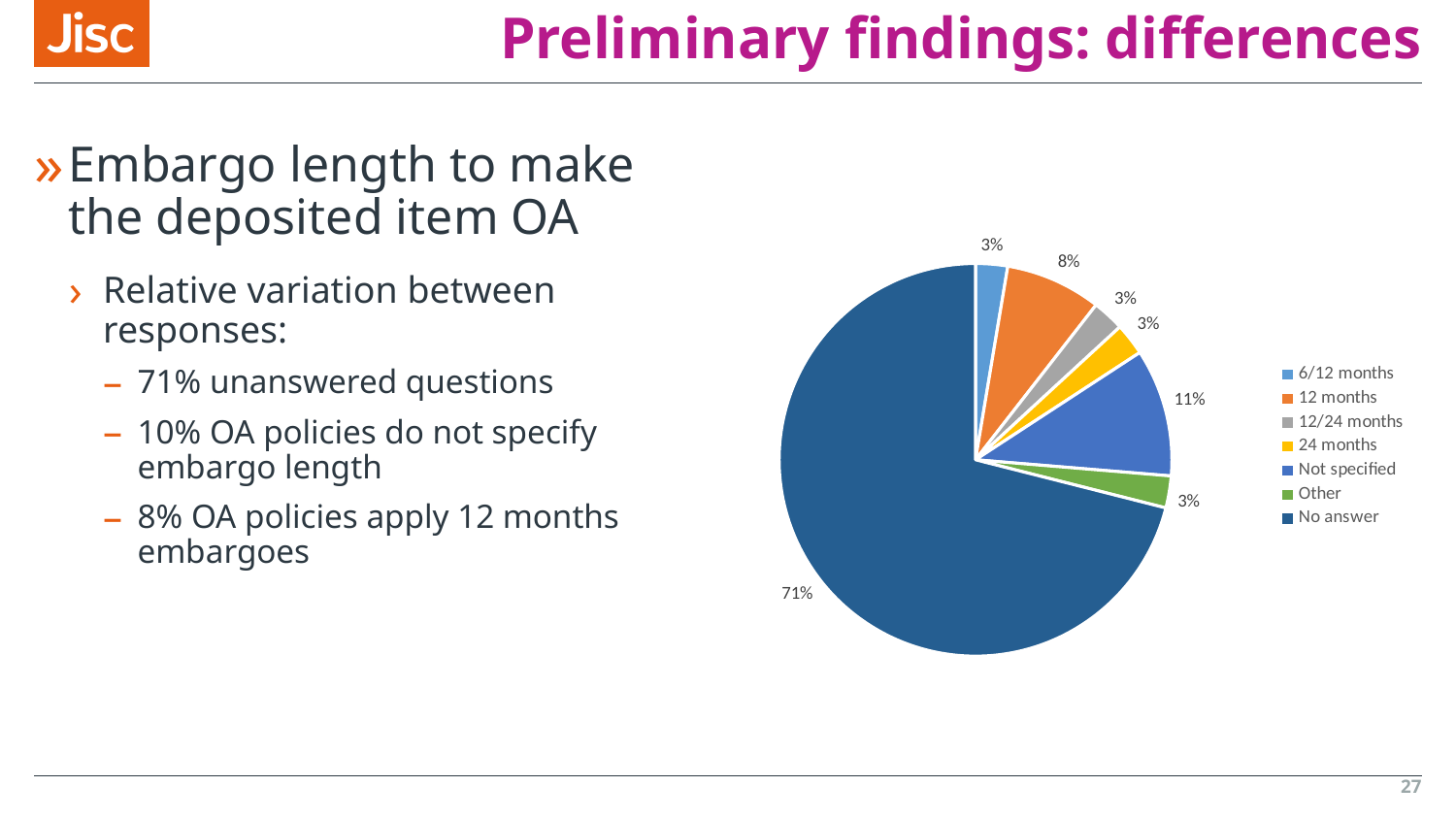
What is the difference between the "No answer" share and the "Not specified" share? 60% Which category has the largest slice of the pie? No answer Which legend entry is shown in yellow? 24 months What is the value shown for "12 months"? 8% How many categories does the legend list? 7 Which legend entry is shown in green? Other What type of chart is shown on the slide? Pie chart What is the value shown for "Other"? 3% Which is larger, the share for "12 months" or the share for "Not specified"? Not specified What is the value shown for "Not specified"? 11% What is the difference between the "12 months" share and the "24 months" share? 5% What share of the pie does "No answer" represent? 71%